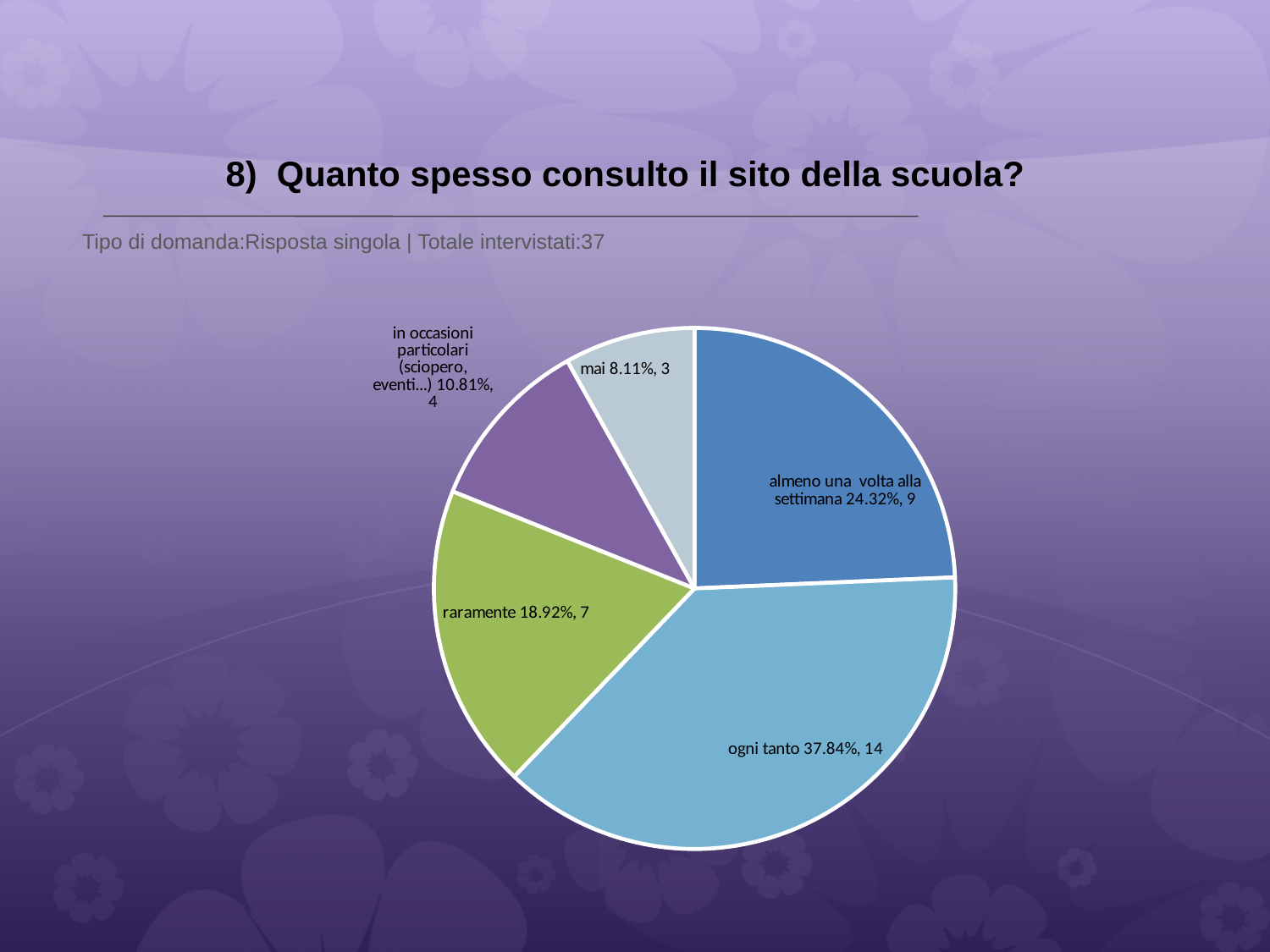
What percentage share does "mai" have? 8.11% How many slices does the pie chart have? 5 Which category has the largest slice? ogni tanto What kind of chart is shown on the slide? pie chart Which has a larger count, "almeno una volta alla settimana" or "raramente"? almeno una volta alla settimana What is the count for "in occasioni particolari (sciopero, eventi...)"? 4 Which category has the smallest slice? mai What is the difference in count between "ogni tanto" and "raramente"? 7 What is the count for "almeno una volta alla settimana"? 9 What is the total number of respondents stated on the slide? 37 What is the count for "ogni tanto"? 14 What percentage share does "raramente" have? 18.92%